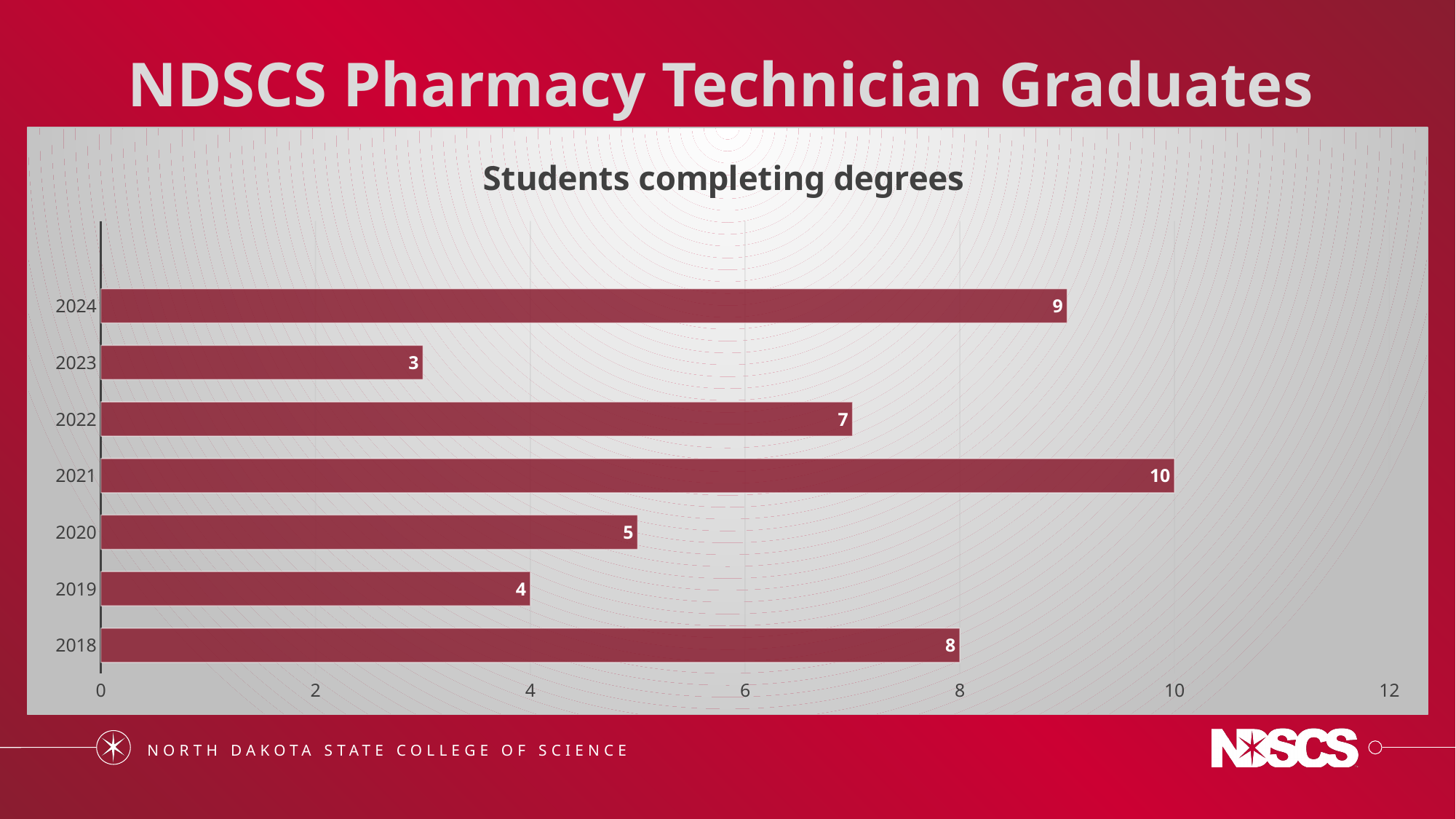
Which year has the highest number of students completing degrees? 2021 What is the title of the chart? Students completing degrees What is the difference between the values for 2024 and 2023? 6 Which year has a larger value, 2020 or 2022? 2022 How many students completed degrees in 2021? 10 What kind of chart is shown on the slide? bar chart What is the highest value shown on the horizontal axis? 12 How many years are shown on the chart? 7 What is the value shown for 2023? 3 Is the value for 2019 greater or less than 6? less How many students completed degrees in 2018? 8 Which year has the lowest number of students completing degrees? 2023